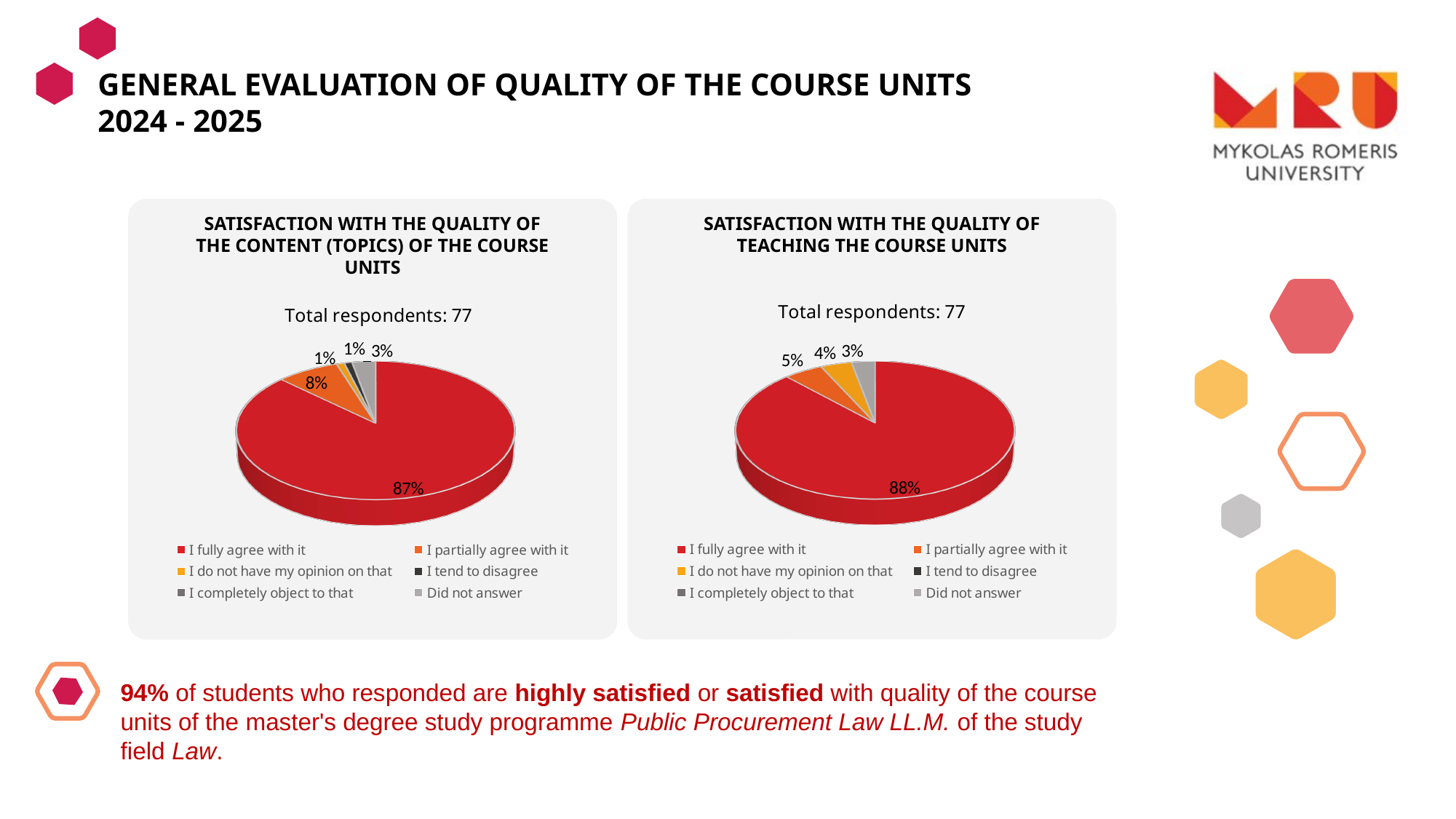
In the chart titled 'Satisfaction with the quality of teaching the course units', what percentage of respondents chose 'I do not have my opinion on that'? 4% In the chart titled 'Satisfaction with the quality of the content (topics) of the course units', what percentage of respondents chose 'I fully agree with it'? 87% Which chart has the larger share for 'I fully agree with it': the content (topics) chart or the teaching chart? The teaching chart In the chart titled 'Satisfaction with the quality of the content (topics) of the course units', what percentage of respondents 'Did not answer'? 3% How many total respondents are reported for the 'Satisfaction with the quality of teaching the course units' chart? 77 What type of chart is used in the 'Satisfaction with the quality of teaching the course units' chart? Pie chart In the chart titled 'Satisfaction with the quality of teaching the course units', what percentage of respondents chose 'I fully agree with it'? 88% In the chart titled 'Satisfaction with the quality of teaching the course units', what percentage of respondents chose 'I partially agree with it'? 5% In the chart titled 'Satisfaction with the quality of teaching the course units', which response has the largest share? I fully agree with it In the chart titled 'Satisfaction with the quality of teaching the course units', what is the difference in percentage points between 'I fully agree with it' and 'I partially agree with it'? 83 How many entries does the legend of the 'Satisfaction with the quality of the content (topics) of the course units' chart list? 6 In the chart titled 'Satisfaction with the quality of the content (topics) of the course units', what percentage of respondents chose 'I partially agree with it'? 8%